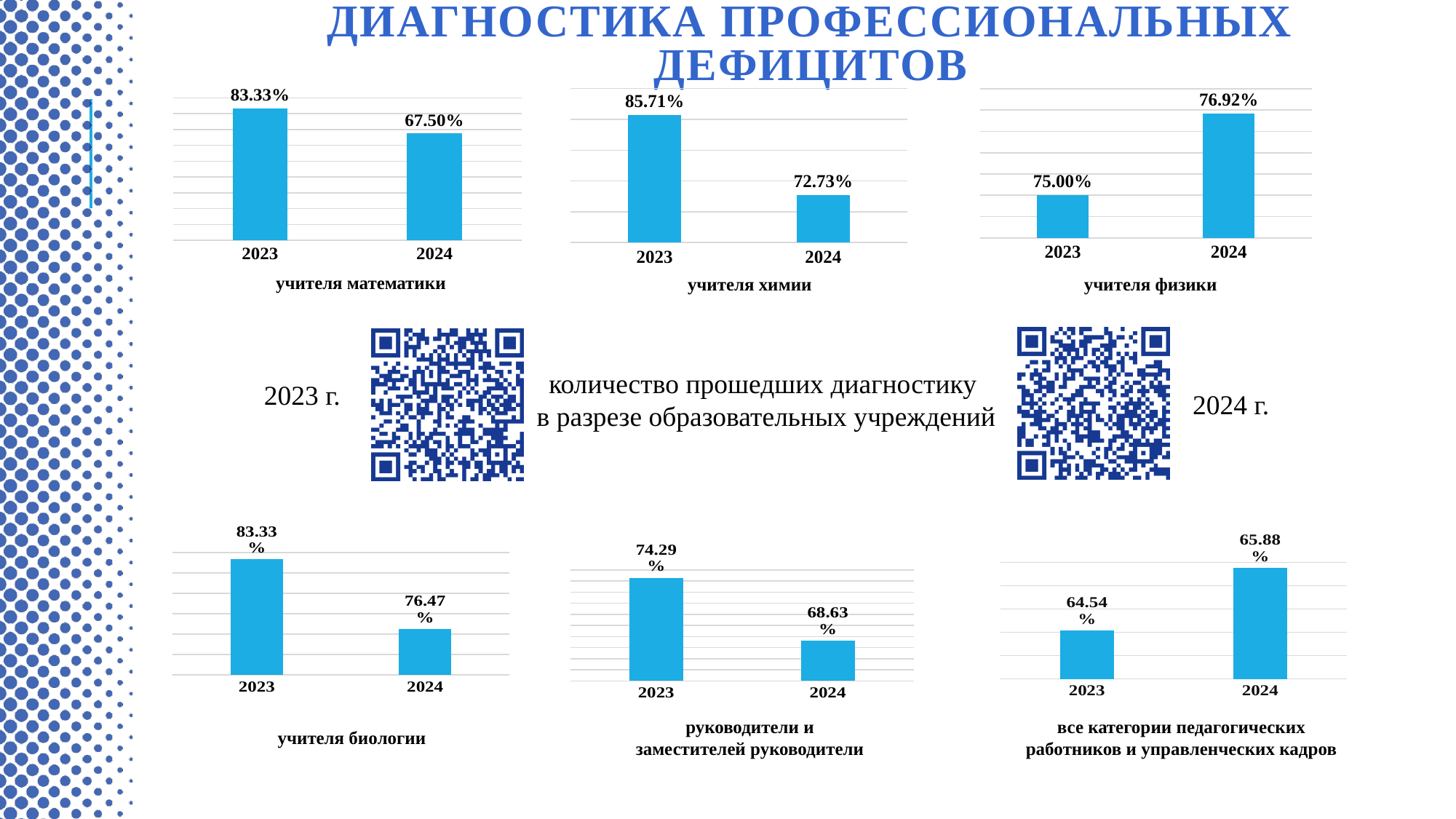
In the chart for все категории педагогических работников и управленческих кадров, which year has the higher value? 2024 What type of chart is used for учителя математики? bar chart In the chart for учителя химии, what is the value for 2024? 72.73% In the chart for учителя математики, what is the value for 2023? 83.33% In the chart for учителя физики, what is the value for 2024? 76.92% In the chart for учителя химии, which year has the lower value? 2024 In the chart for руководители и заместителей руководители, what is the value for 2023? 74.29% In the chart for учителя физики, is the value for 2023 larger or smaller than the value for 2024? smaller In the chart for учителя математики, what is the difference between the 2023 and 2024 values? 15.83% In the chart for учителя биологии, do the values rise or fall from 2023 to 2024? fall How many bars are in the chart for руководители и заместителей руководители? 2 In the chart for учителя биологии, what is the value for 2024? 76.47%